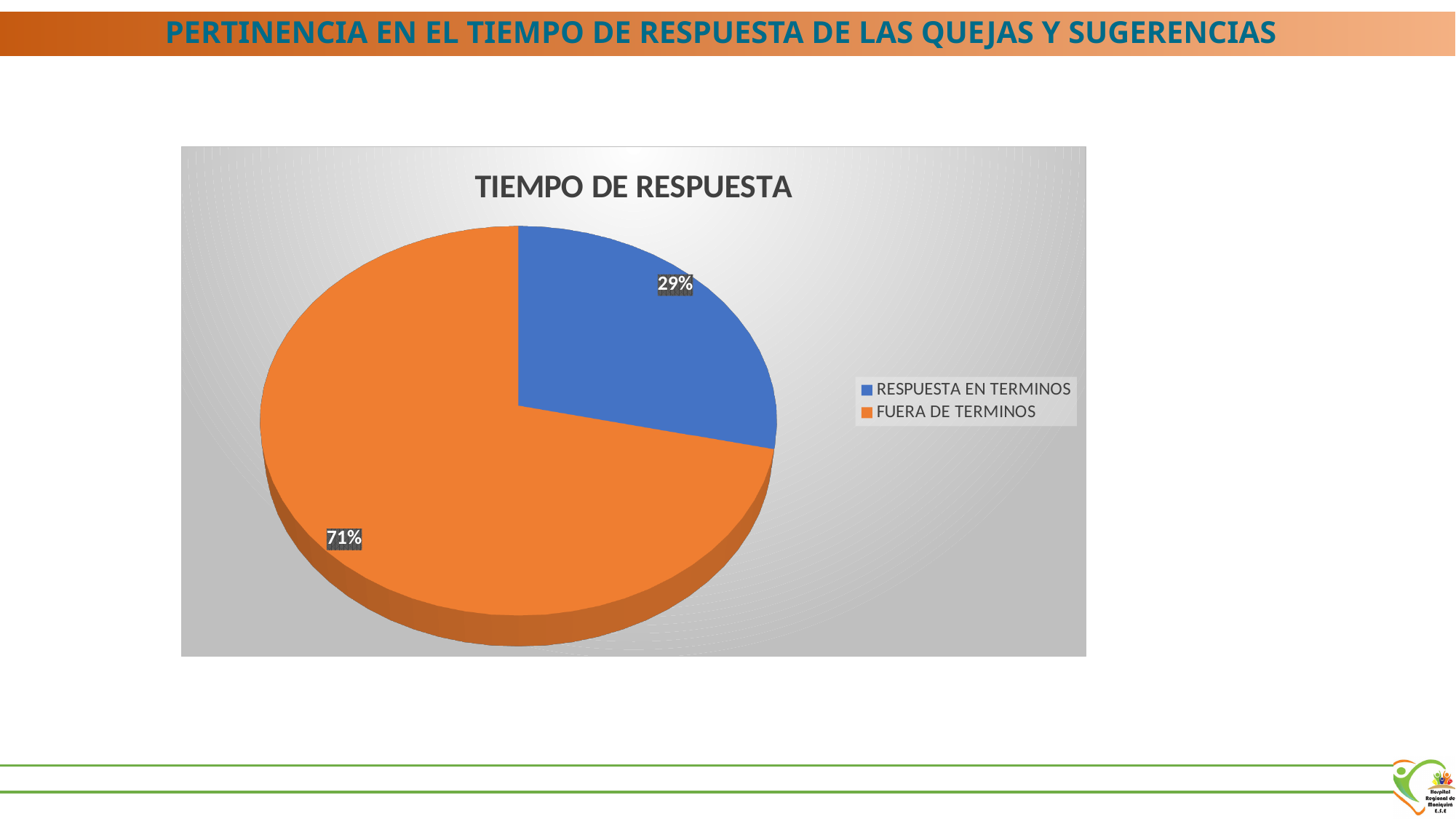
What is the difference in percentage points between FUERA DE TERMINOS and RESPUESTA EN TERMINOS? 42 What type of chart is shown on the slide? Pie chart What is the title of the chart? TIEMPO DE RESPUESTA Which category has the largest share of the pie? FUERA DE TERMINOS What percentage is shown for RESPUESTA EN TERMINOS? 29% What percentage is shown for FUERA DE TERMINOS? 71% What share of the pie does RESPUESTA EN TERMINOS represent? 29% What colour is the slice for FUERA DE TERMINOS? Orange How many slices does the pie chart have? 2 How many entries does the legend list? 2 Which is larger, RESPUESTA EN TERMINOS or FUERA DE TERMINOS? FUERA DE TERMINOS Which category has the smallest share of the pie? RESPUESTA EN TERMINOS